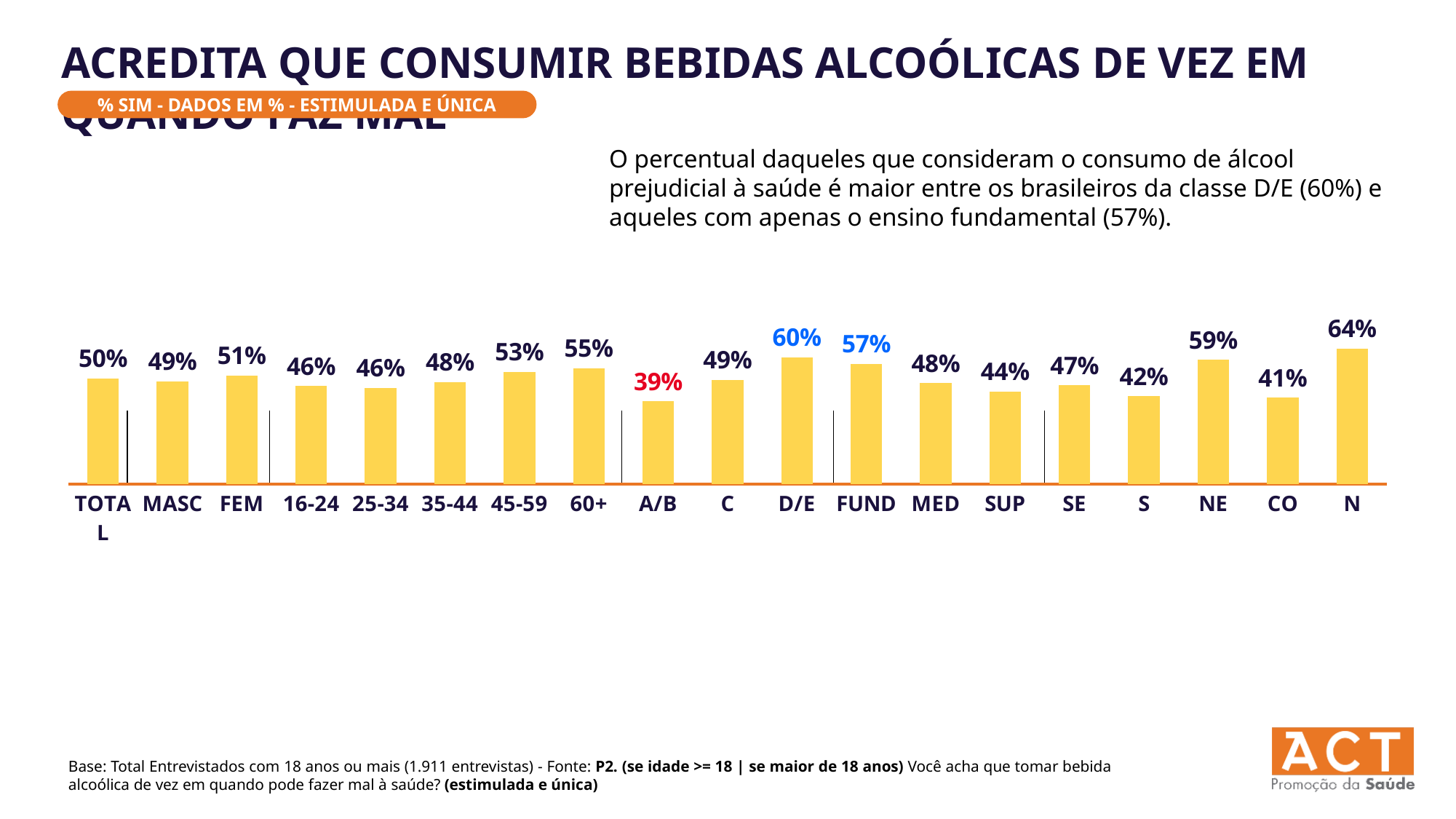
How many categories are shown in the chart? 19 What is the difference between the values for N and CO? 23% What is the value for NE? 59% What is the value for A/B? 39% Which category has the lowest value? A/B What is the value for D/E? 60% Which is larger, the value for FUND or the value for SUP? FUND What is the value for TOTAL? 50% Which is larger, the value for 60+ or the value for 16-24? 60+ What is the difference between the values for D/E and A/B? 21% What kind of chart is shown on the slide? Bar chart Which category has the highest value? N